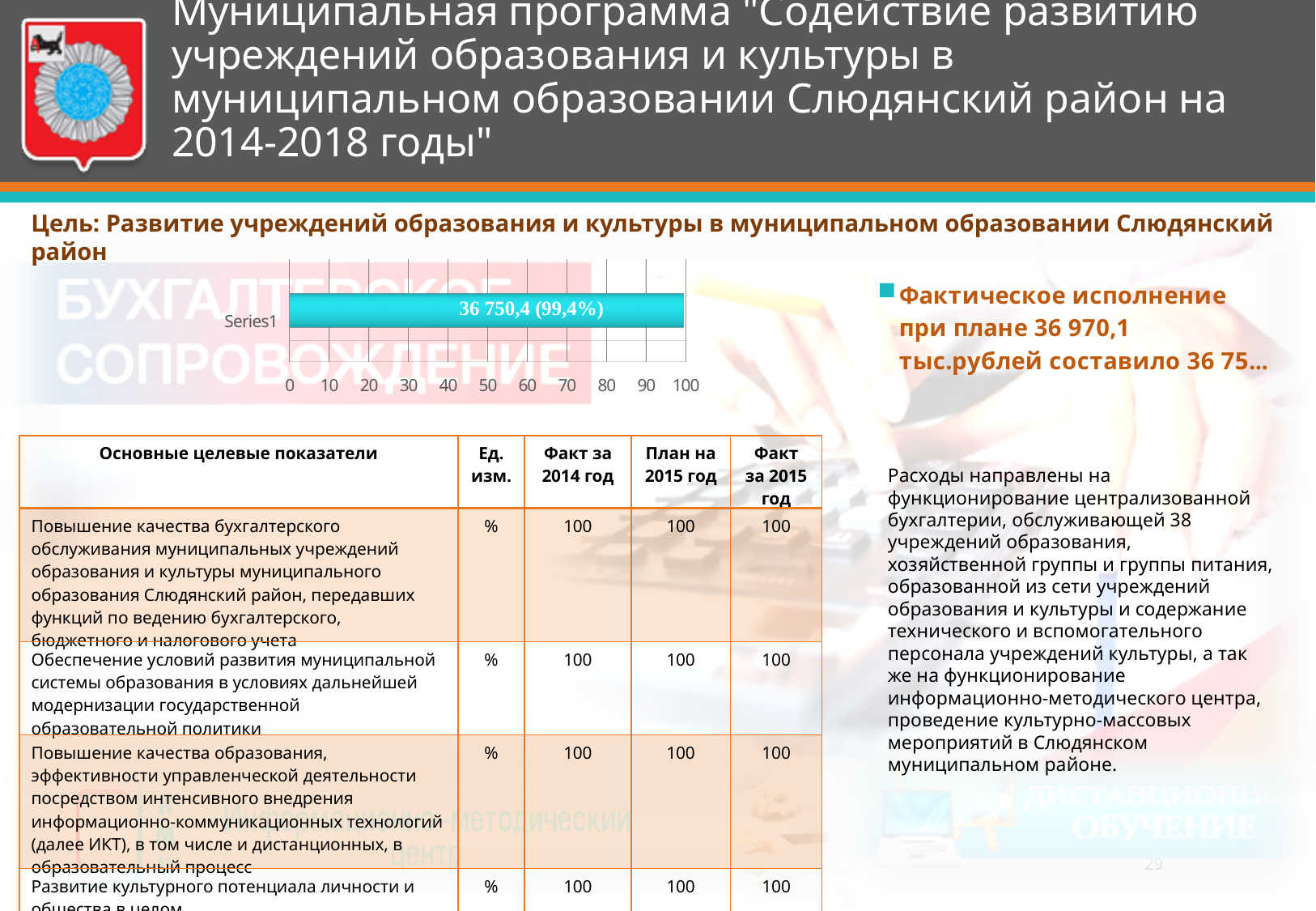
Is the value for Series1 greater or less than 90 on the axis? greater Are the bars in the chart horizontal or vertical? horizontal What is the category label shown next to the bar? Series1 Is the value for Series1 greater or less than 50 on the axis? greater What percentage is shown in the data label on the bar? 99,4% What data label is printed on the bar in the chart? 36 750,4 (99,4%) What is the highest tick value shown on the horizontal axis of the chart? 100 What kind of chart is shown on the slide? bar chart How many bars does the chart contain? 1